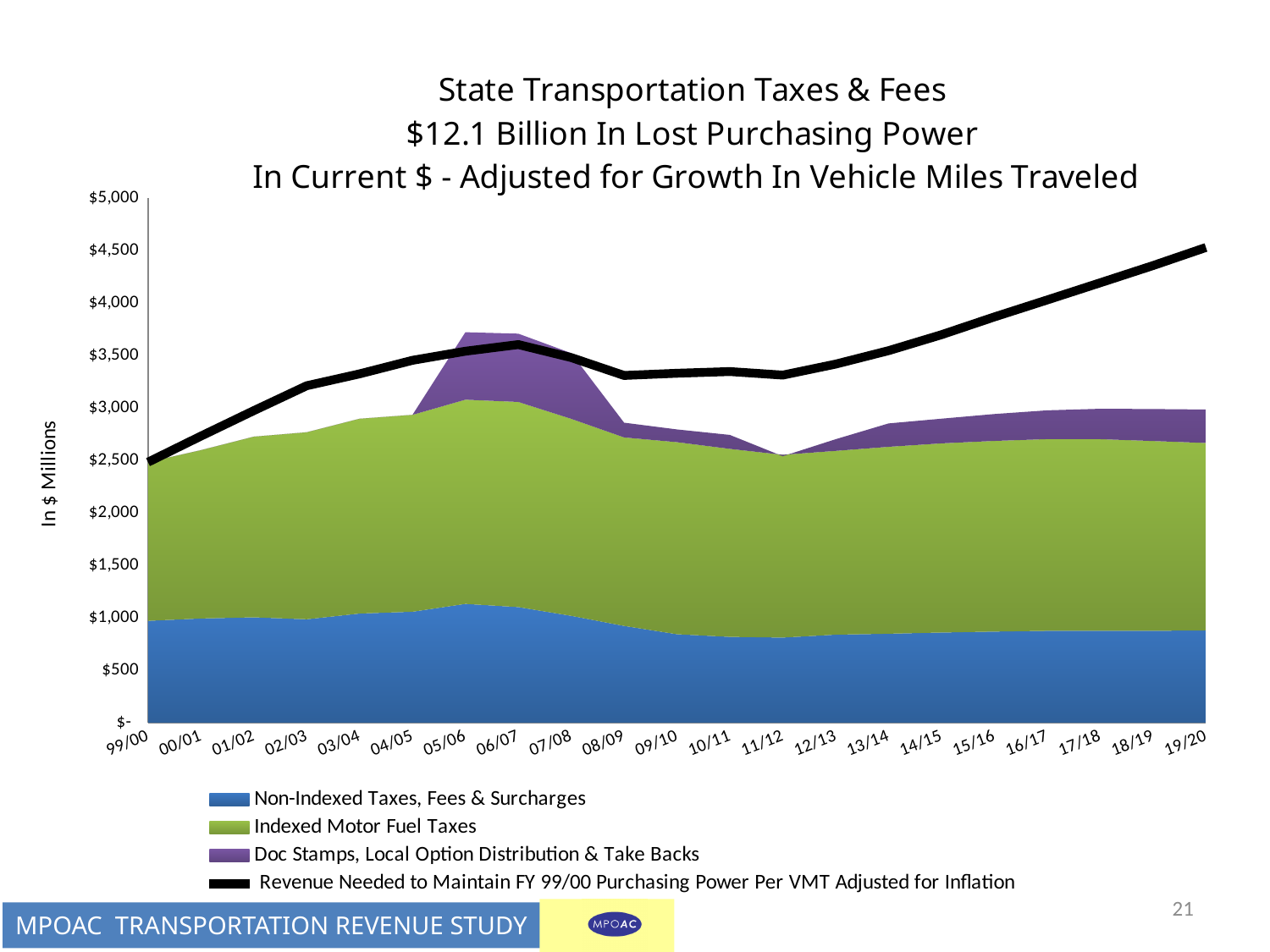
Is the Revenue Needed line value for 11/12 greater or less than $3,000? greater Does the Revenue Needed line generally rise or fall from 99/00 to 19/20? Rise Is the Non-Indexed Taxes, Fees & Surcharges value for 09/10 greater or less than $1,000? less Is the total of the stacked areas for 05/06 greater or less than $3,500? greater What is the label on the y axis? In $ Millions At 19/20, which is higher: the Revenue Needed line or the top of the stacked areas? The Revenue Needed line Which legend entry is drawn as a black line? Revenue Needed to Maintain FY 99/00 Purchasing Power Per VMT Adjusted for Inflation What kind of chart is shown on the slide? Stacked area chart with a line Is the Revenue Needed line higher at 19/20 or at 99/00? 19/20 How many series does the legend list? 4 How many fiscal years are shown along the x axis? 21